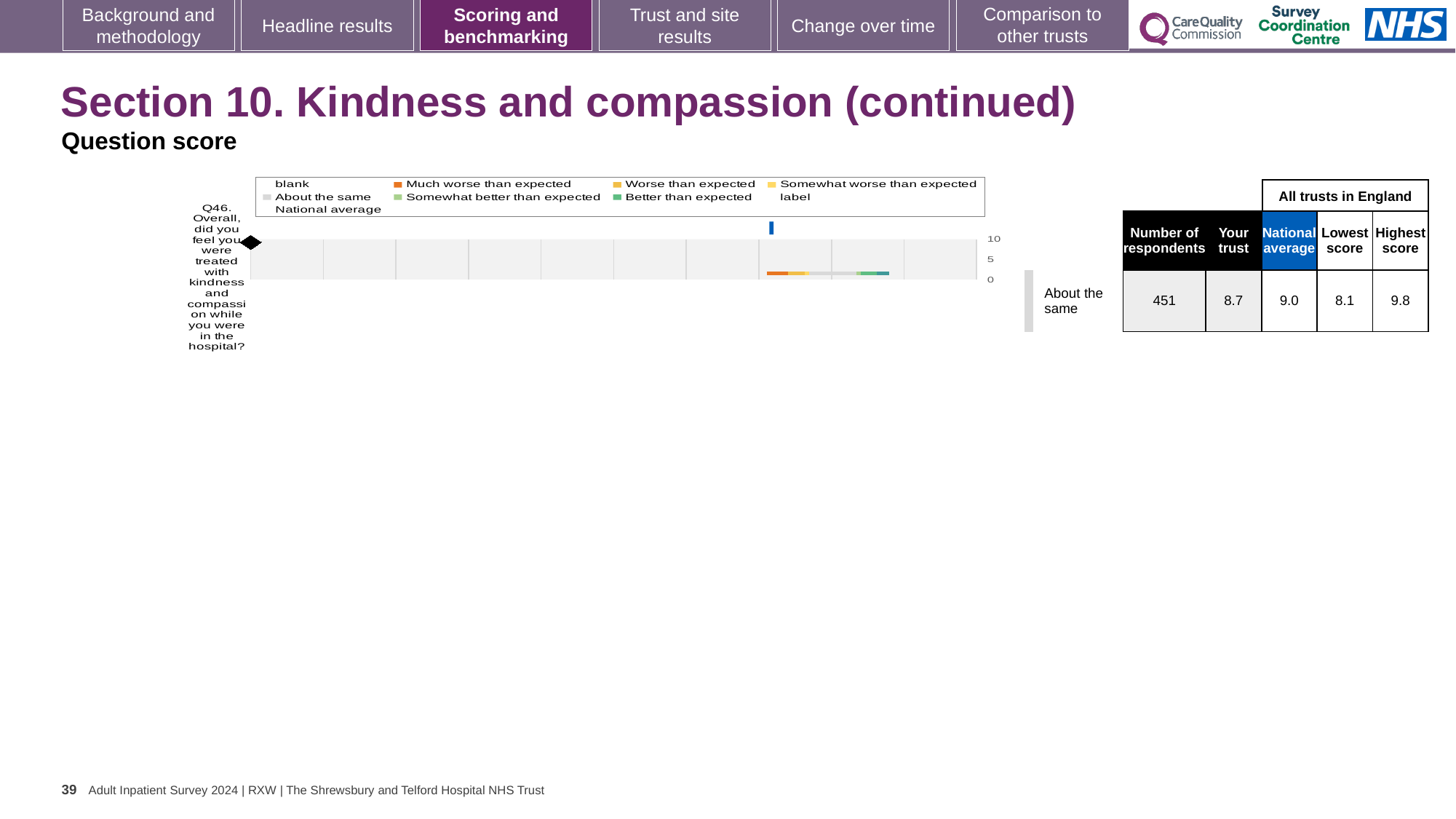
What is the national average score for Q46? 9.0 What is the highest score among all trusts in England for Q46? 9.8 What is the difference between the highest score and the lowest score for Q46? 1.7 How many survey questions are plotted on the chart? 1 What is the difference between the national average and the 'Your trust' score for Q46? 0.3 What is the 'Your trust' score for Q46 (treated with kindness and compassion)? 8.7 What kind of chart is shown on the slide for Q46? bar chart What is the highest value shown on the chart's score axis? 10 Which is larger for Q46, the 'Your trust' score or the national average? National average What is the lowest score among all trusts in England for Q46? 8.1 How many respondents answered Q46? 451 Which benchmarking category is the trust's Q46 score placed in? About the same